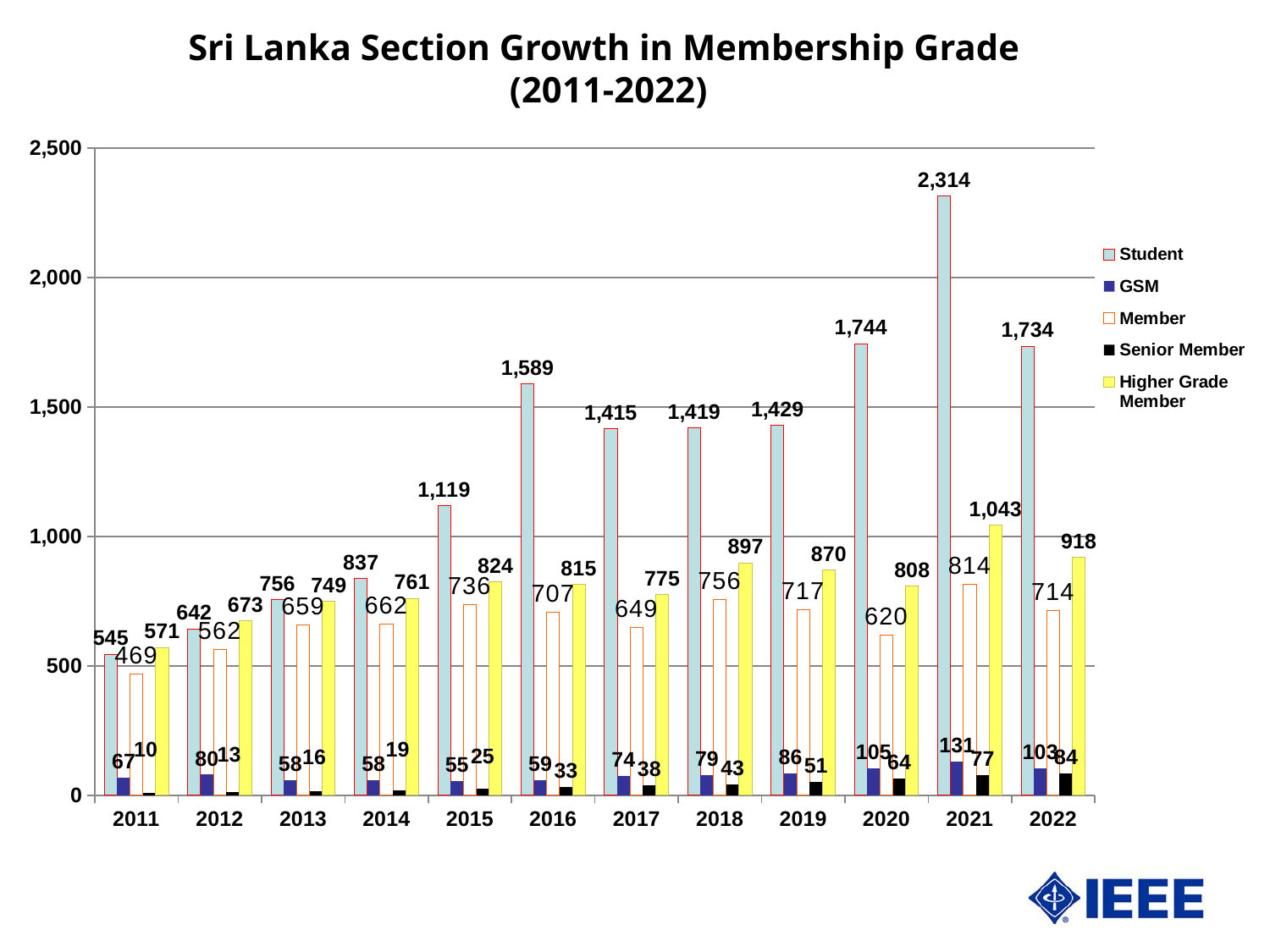
What is the difference between the Student values for 2021 and 2022? 580 What is the Senior Member value for 2022? 84 How many series does the legend list? 5 In which year is the Senior Member value lowest? 2011 In which year is the Student value highest? 2021 Do the Senior Member values rise or fall from 2011 to 2022? Rise Which is larger, the Member value for 2016 or the Member value for 2018? 2018 How many years are shown on the x axis? 12 What is the Higher Grade Member value for 2018? 897 What is the Student value for 2021? 2,314 What is the Member value for 2015? 736 What kind of chart is this? Bar chart